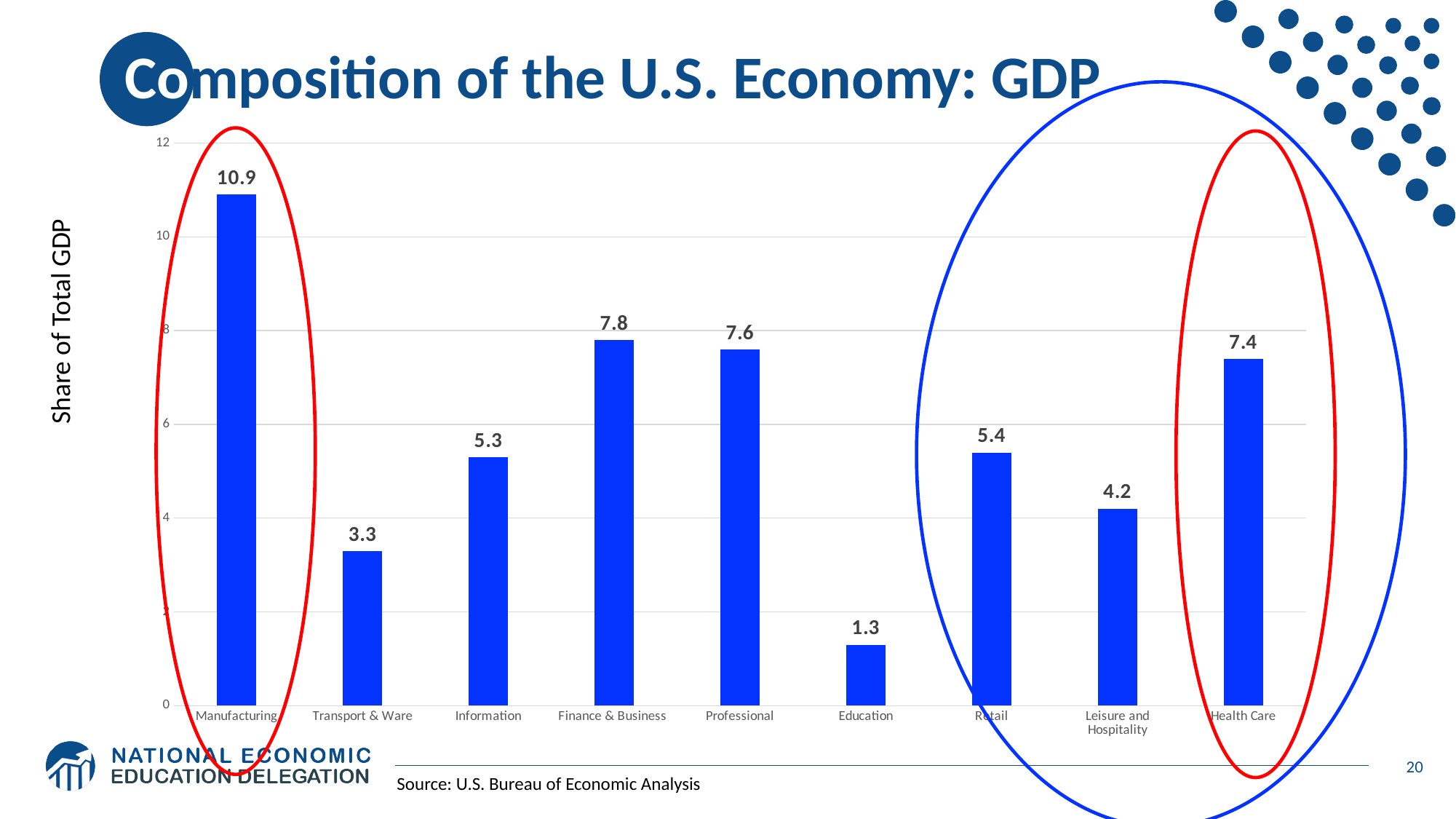
What kind of chart is shown on the slide? Bar chart What is the difference between the values for Retail and Leisure and Hospitality? 1.2 What is the difference between the values for Manufacturing and Health Care? 3.5 Which is larger, the value for Information or the value for Transport & Ware? Information What is the value shown for Education? 1.3 How many categories are shown on the x axis? 9 What is the value shown for Leisure and Hospitality? 4.2 Is the value for Finance & Business greater or less than 6? greater What is the share of total GDP for Health Care? 7.4 What is the share of total GDP for Manufacturing? 10.9 Which category has the lowest share of total GDP? Education Which category has the highest share of total GDP? Manufacturing